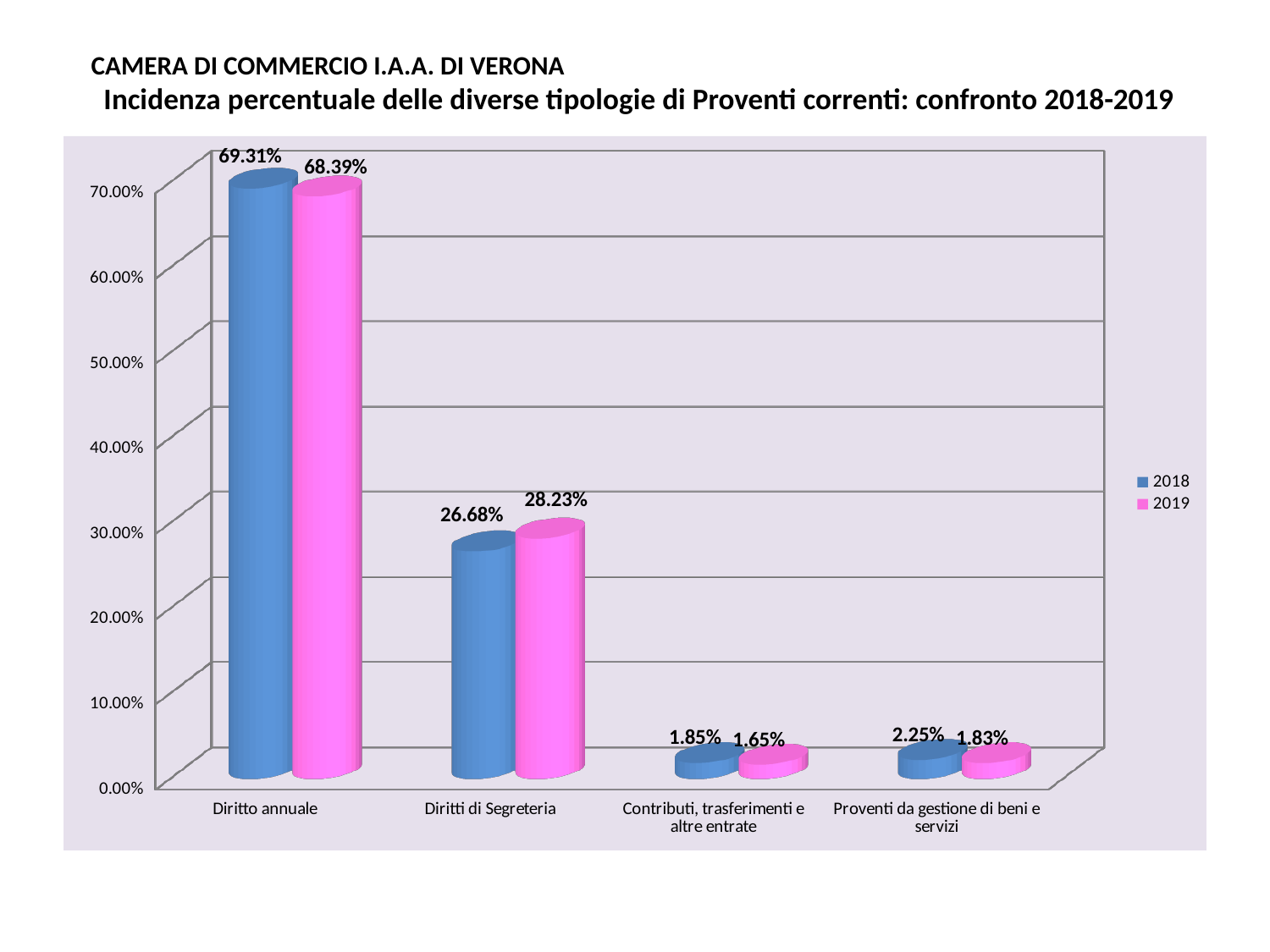
What is the value for Proventi da gestione di beni e servizi in 2018? 2.25% What is the value for Diritti di Segreteria in 2019? 28.23% What is the difference between the 2019 and 2018 values for Diritti di Segreteria? 1.55% What is the value for Contributi, trasferimenti e altre entrate in 2019? 1.65% How many categories are shown on the x axis? 4 Which category has the highest value in 2019? Diritto annuale What is the difference between the 2018 and 2019 values for Diritto annuale? 0.92% How many series does the legend list? 2 Which is larger for Proventi da gestione di beni e servizi, the 2018 value or the 2019 value? 2018 Which category has the lowest value in 2018? Contributi, trasferimenti e altre entrate What kind of chart is shown on the slide? Bar chart What is the value for Diritto annuale in 2018? 69.31%